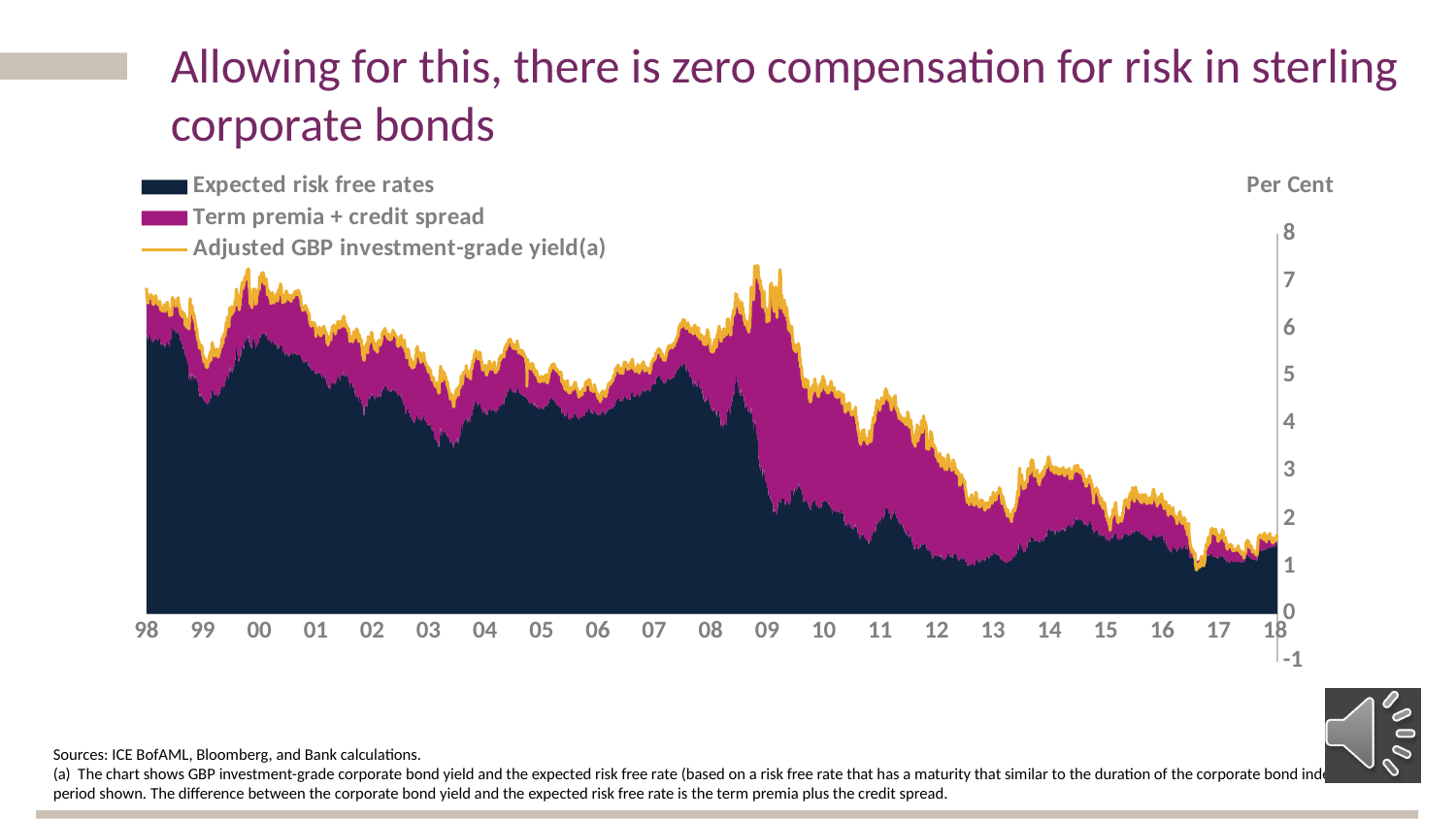
Is the Expected risk free rates value at 16 greater or less than 2? less Which series is shown in magenta/purple in the chart? Term premia + credit spread What type of chart is shown on the slide? Stacked area chart with a line overlay How many year labels are shown on the x axis? 21 Is the Adjusted GBP investment-grade yield at 98 greater or less than 5? greater Overall, does the Adjusted GBP investment-grade yield rise or fall from 98 to 18? Fall What unit is shown on the y axis of the chart? Per Cent Is the Expected risk free rates value at 98 greater or less than 5? greater How many series does the legend list? 3 Which is larger, the Adjusted GBP investment-grade yield at 98 or at 18? 98